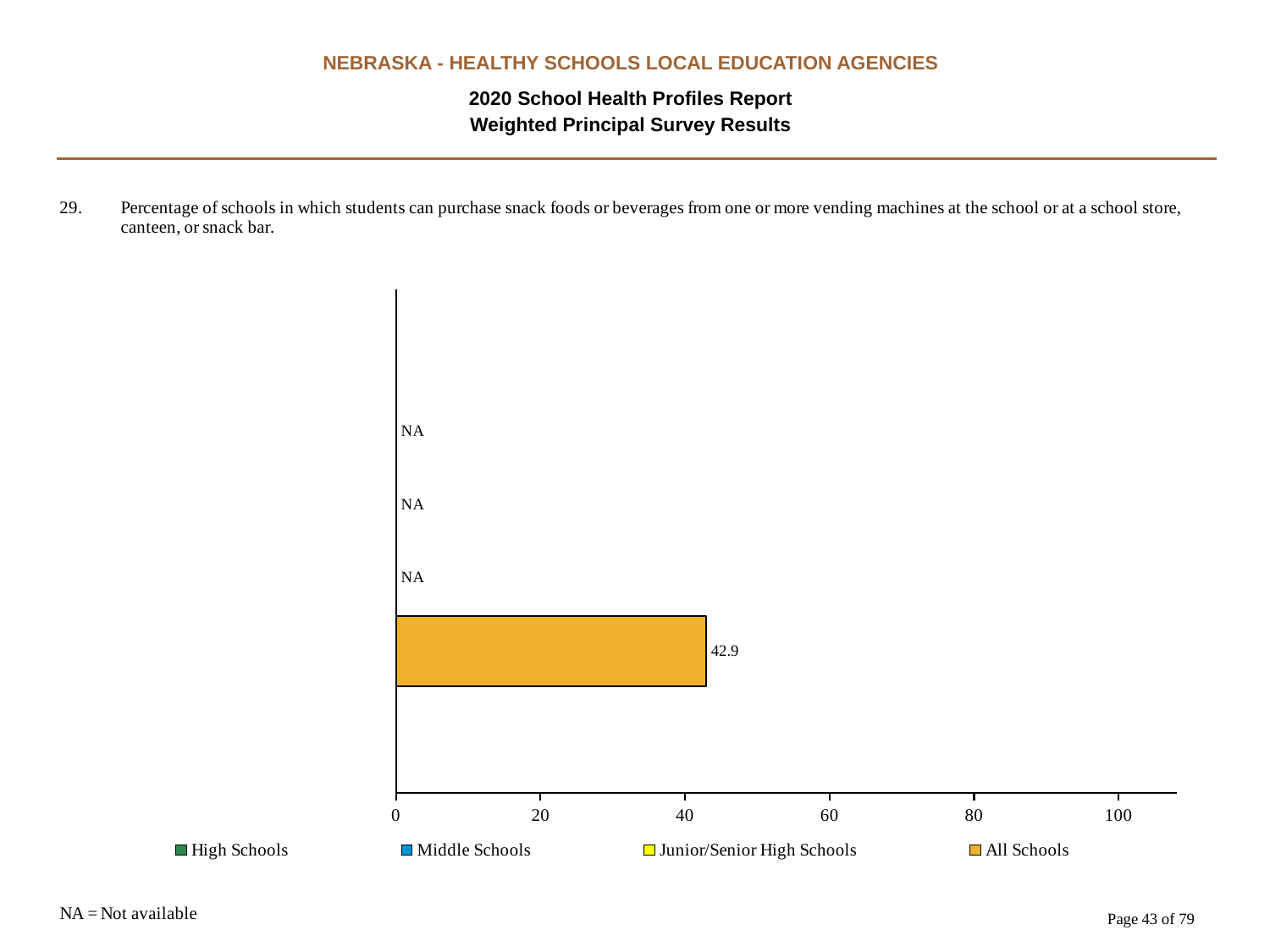
Is the value for All Schools greater or less than 60? less What is the value for All Schools? 42.9 How many series does the legend list? 4 Is the value for All Schools greater or less than 40? greater What is shown for Middle Schools? NA What is the highest value shown on the x axis? 100 What kind of chart is shown on the slide? bar chart What is shown for High Schools? NA What is shown for Junior/Senior High Schools? NA Which series is the only one with a plotted value rather than NA? All Schools How many series are marked NA? 3